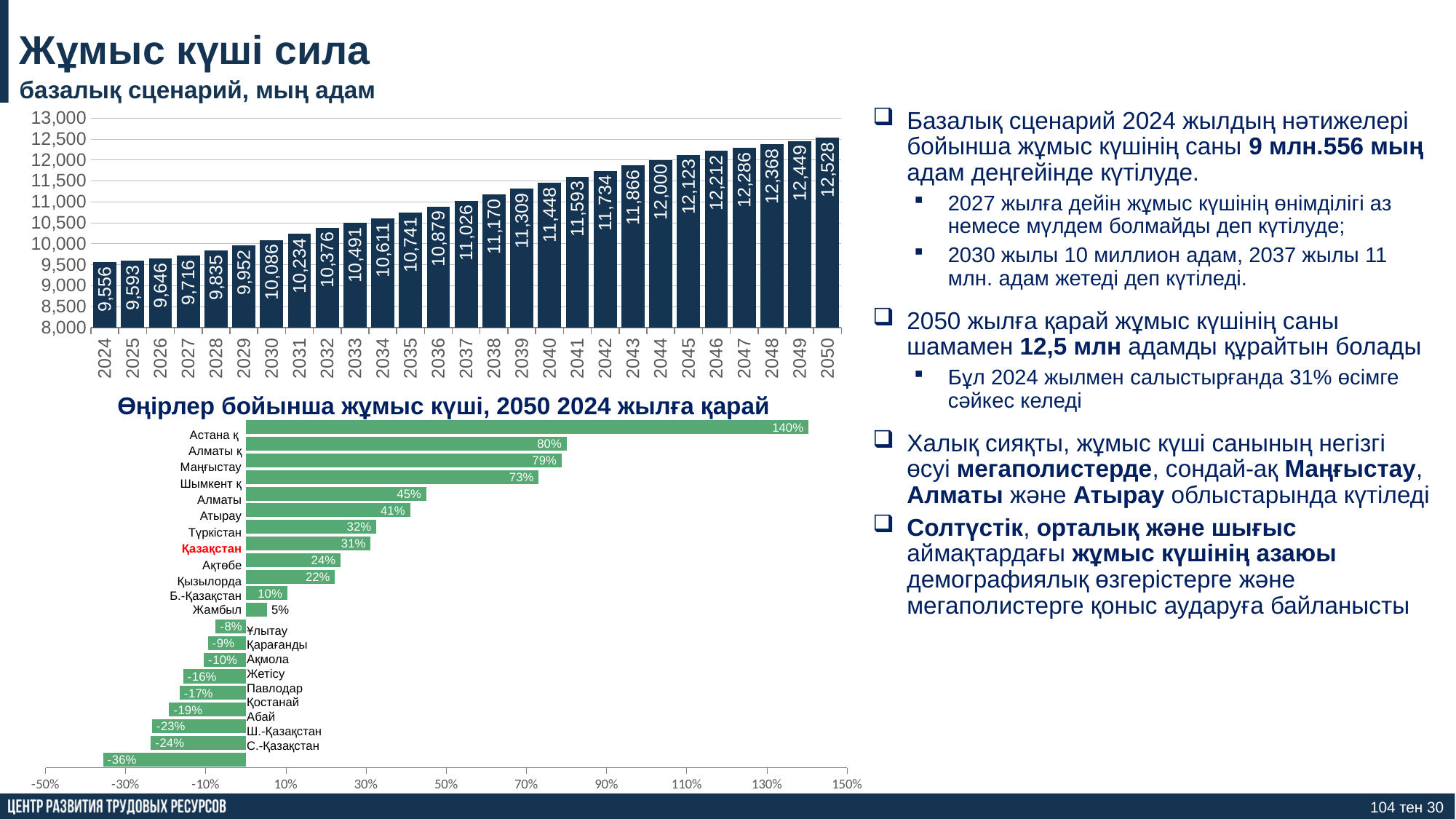
In the bottom chart (Өңірлер бойынша жұмыс күші), what is the value for Астана қ? 140% In the bottom chart (Өңірлер бойынша жұмыс күші), what is the value for Қазақстан? 31% In the bottom chart (Өңірлер бойынша жұмыс күші), which region has the highest value? Астана қ In the bottom chart (Өңірлер бойынша жұмыс күші), which region has the lowest value? С.-Қазақстан In the bottom chart (Өңірлер бойынша жұмыс күші), which is larger, the value for Алматы or the value for Атырау? Алматы In the top chart (базалық сценарий, мың адам), what is the difference between the values for 2050 and 2024? 2,972 In the top chart (базалық сценарий, мың адам), do the values rise or fall from 2024 to 2050? rise In the top chart (базалық сценарий, мың адам), what is the value for 2024? 9,556 What kind of chart is the top chart (базалық сценарий, мың адам)? bar chart In the top chart (базалық сценарий, мың адам), what is the value for 2050? 12,528 In the top chart (базалық сценарий, мың адам), how many years are plotted? 27 In the top chart (базалық сценарий, мың адам), what is the value for 2037? 11,026